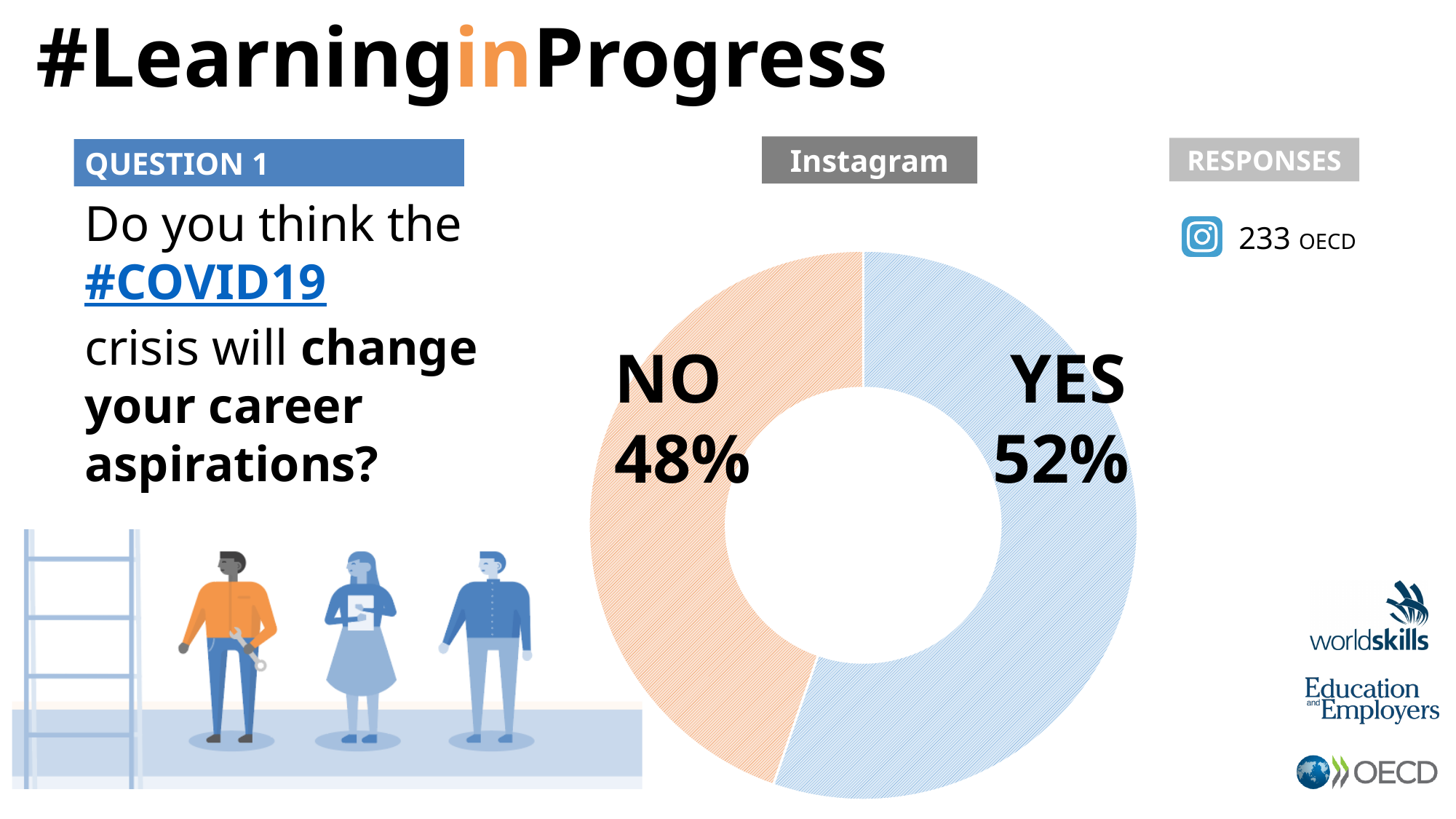
How many response categories are shown in the chart? 2 How many responses were collected for this question? 233 What percentage of respondents answered NO? 48% Is the share for NO greater or less than 50%? less Which response received the larger share, YES or NO? YES Which response has the smallest share of the chart? NO What is the total of the YES and NO shares shown on the chart? 100% Which social media platform were the responses collected from? Instagram What kind of chart is used to show the responses? Doughnut (pie) chart What percentage of respondents answered YES? 52% What is the difference in percentage points between the YES and NO shares? 4 percentage points